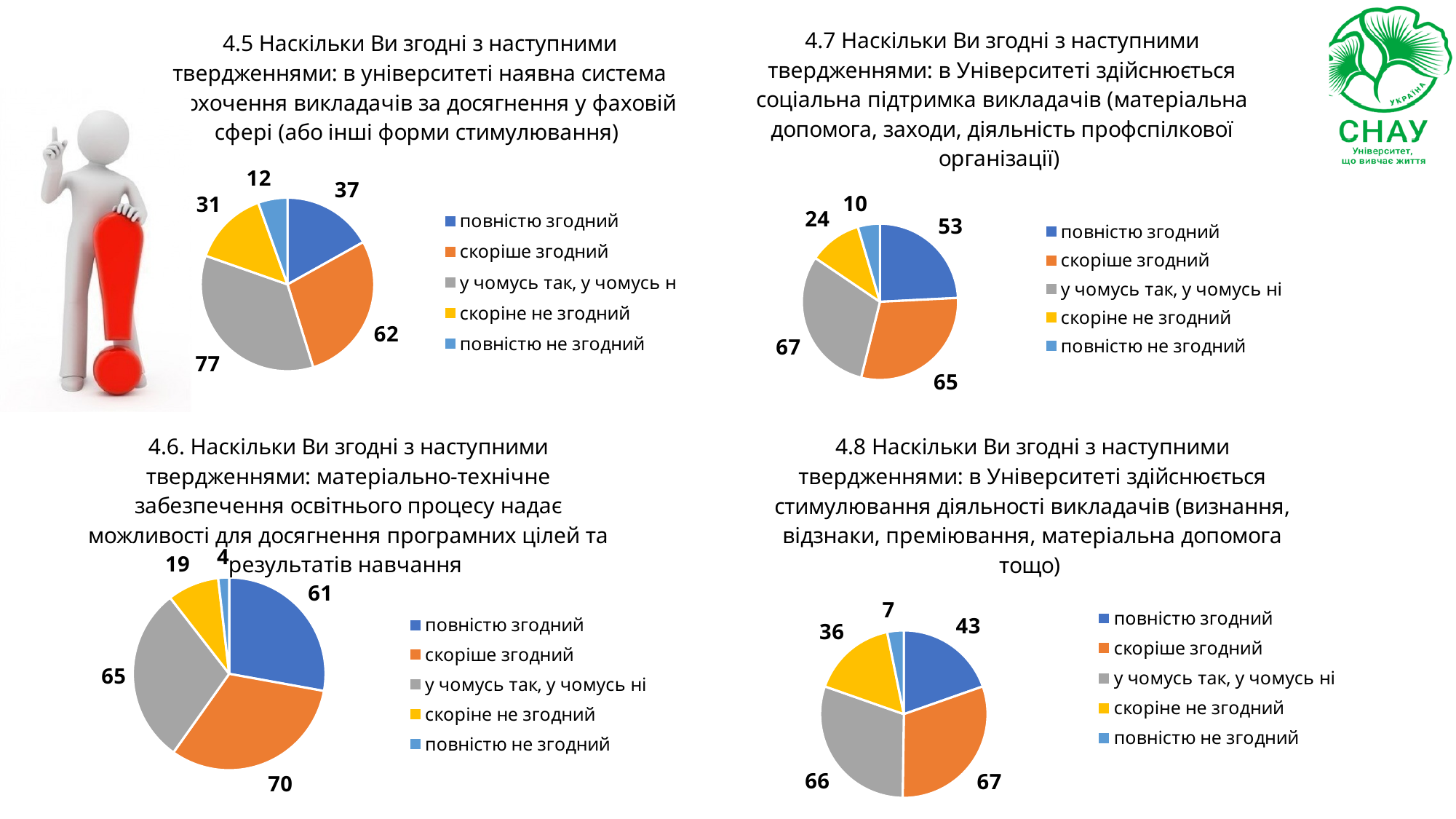
What type of chart is used for question 4.7 (top-right)? pie chart In the chart for question 4.5 (top-left), what is the value for 'у чомусь так, у чомусь ні'? 77 In the chart for question 4.5 (top-left), which category has the smallest slice? повністю не згодний In the chart for question 4.8 (bottom-right), which is larger: 'повністю згодний' or 'скоріне не згодний'? повністю згодний In the chart for question 4.5 (top-left), what colour is the 'скоріне не згодний' slice? yellow In the chart for question 4.7 (top-right), what is the value for 'повністю згодний'? 53 How many slices does the chart for question 4.6 (bottom-left) have? 5 In the chart for question 4.6 (bottom-left), what is the value for 'скоріше згодний'? 70 In the chart for question 4.6 (bottom-left), which category has the largest slice? скоріше згодний In the chart for question 4.8 (bottom-right), what is the value for 'скоріне не згодний'? 36 How many entries does the legend of the chart for question 4.8 (bottom-right) list? 5 In the chart for question 4.7 (top-right), what is the difference between 'скоріше згодний' and 'скоріне не згодний'? 41